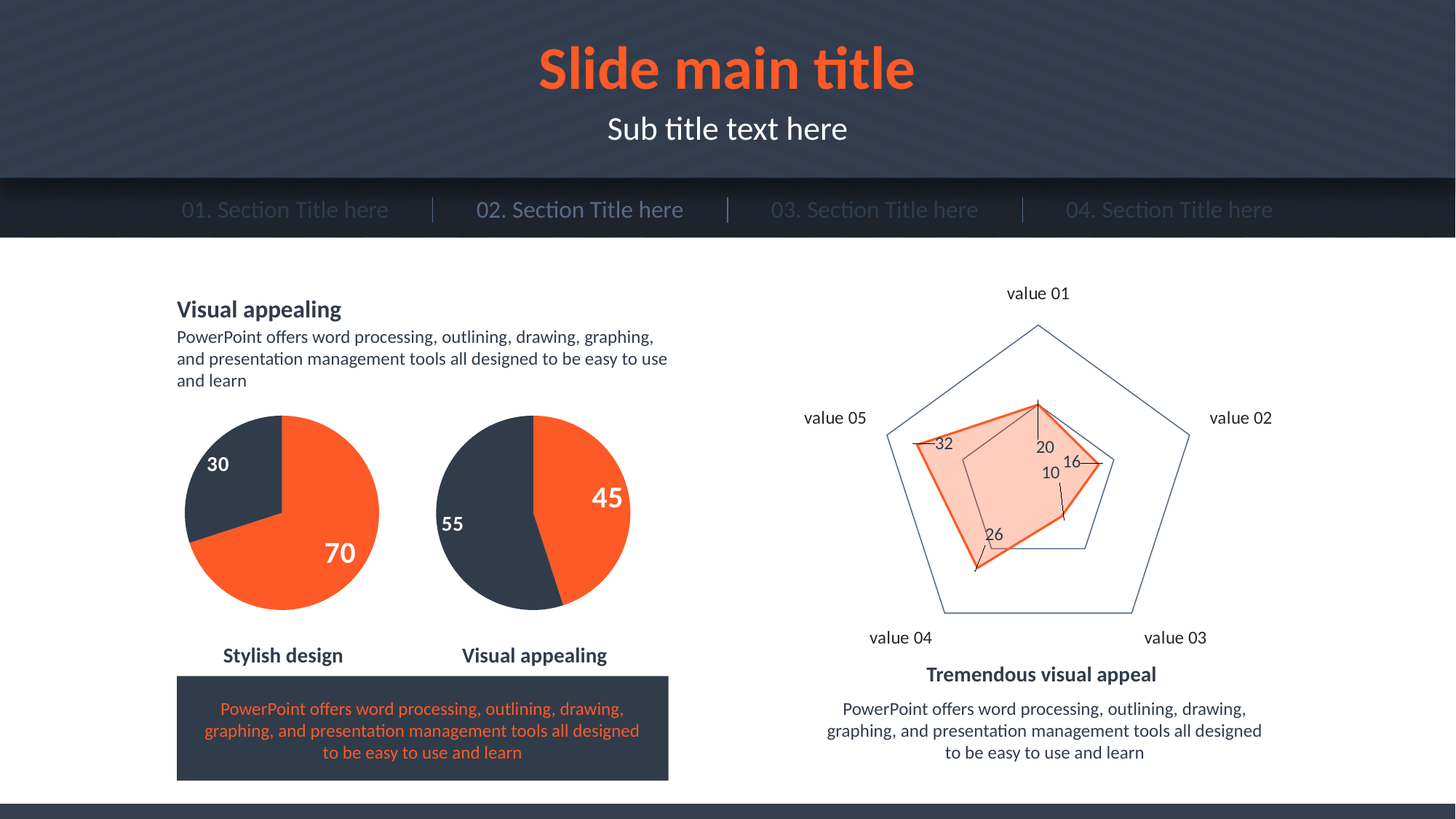
In the radar chart 'Tremendous visual appeal', what is the value for value 03? 10 In the 'Stylish design' pie chart, what is the value of the orange slice? 70 In the 'Stylish design' pie chart, what is the difference between the two slice values? 40 In the radar chart 'Tremendous visual appeal', what is the value for value 05? 32 In the 'Visual appealing' pie chart, which slice is larger, the orange one or the dark one? the dark one How many categories does the radar chart 'Tremendous visual appeal' have? 5 In the radar chart 'Tremendous visual appeal', which category has the lowest value? value 03 In the radar chart 'Tremendous visual appeal', what is the difference between value 04 and value 01? 6 In the radar chart 'Tremendous visual appeal', which category has the highest value? value 05 In the 'Stylish design' pie chart, what is the value of the dark slice? 30 In the 'Visual appealing' pie chart, what is the total of the two slice values? 100 In the 'Visual appealing' pie chart, what is the value of the dark slice? 55